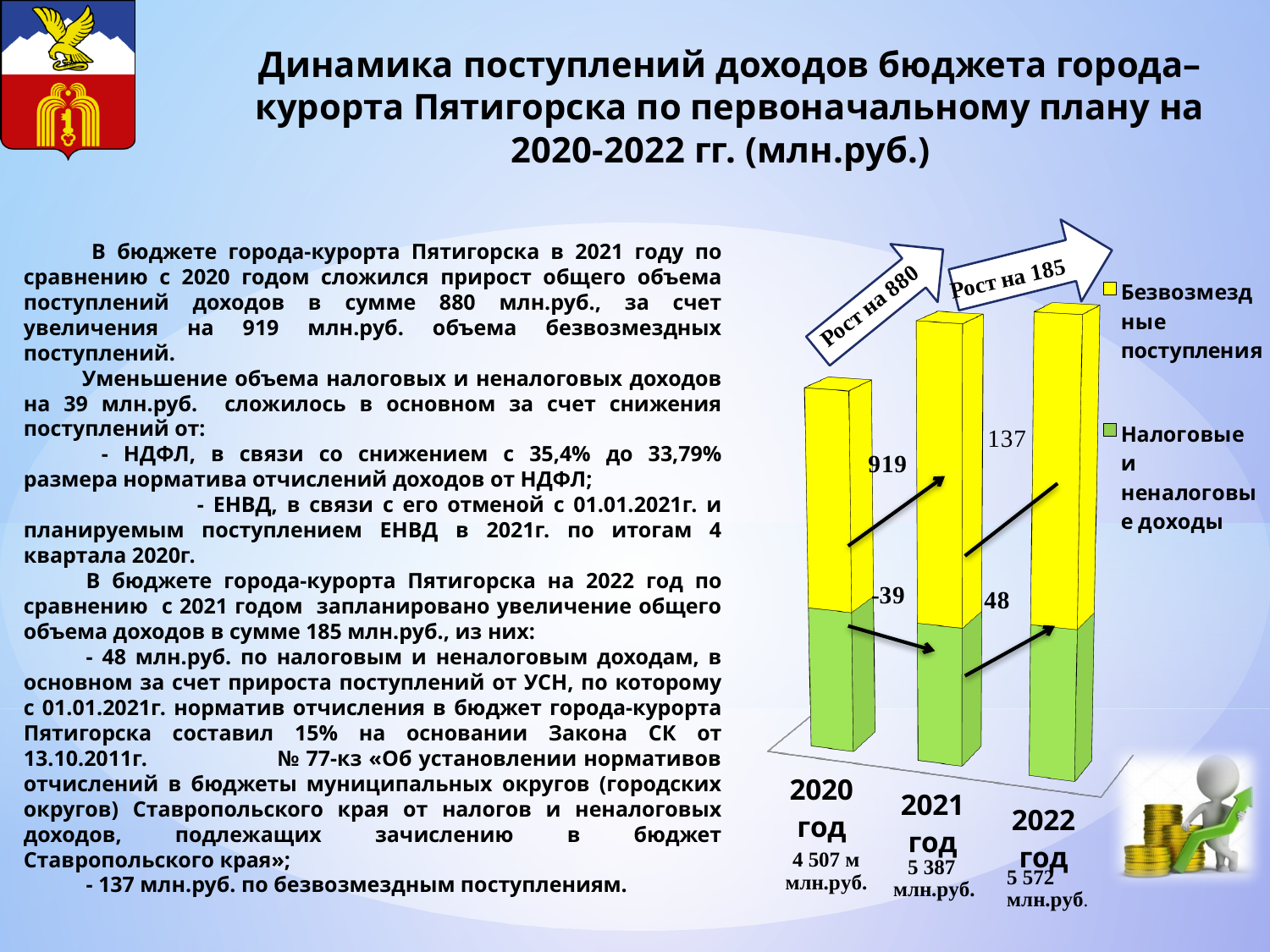
How many series does the chart legend list? 2 Which series is shown in yellow on the chart? Безвозмездные поступления By how much does the total revenue for 2022 exceed that for 2021, according to the chart? 185 What is the total budget revenue shown for 2020 год? 4 507 млн.руб. What is the total budget revenue shown for 2021 год? 5 387 млн.руб. By how much does the total revenue for 2021 exceed that for 2020, according to the chart? 880 Which year has the lowest total revenue on the chart? 2020 год Do the total revenues rise or fall from 2020 to 2022 on the chart? Rise What is the total budget revenue shown for 2022 год? 5 572 млн.руб. What type of chart is shown on the slide? Stacked bar chart Which year has the highest total revenue on the chart? 2022 год How many years (bars) are shown on the chart? 3